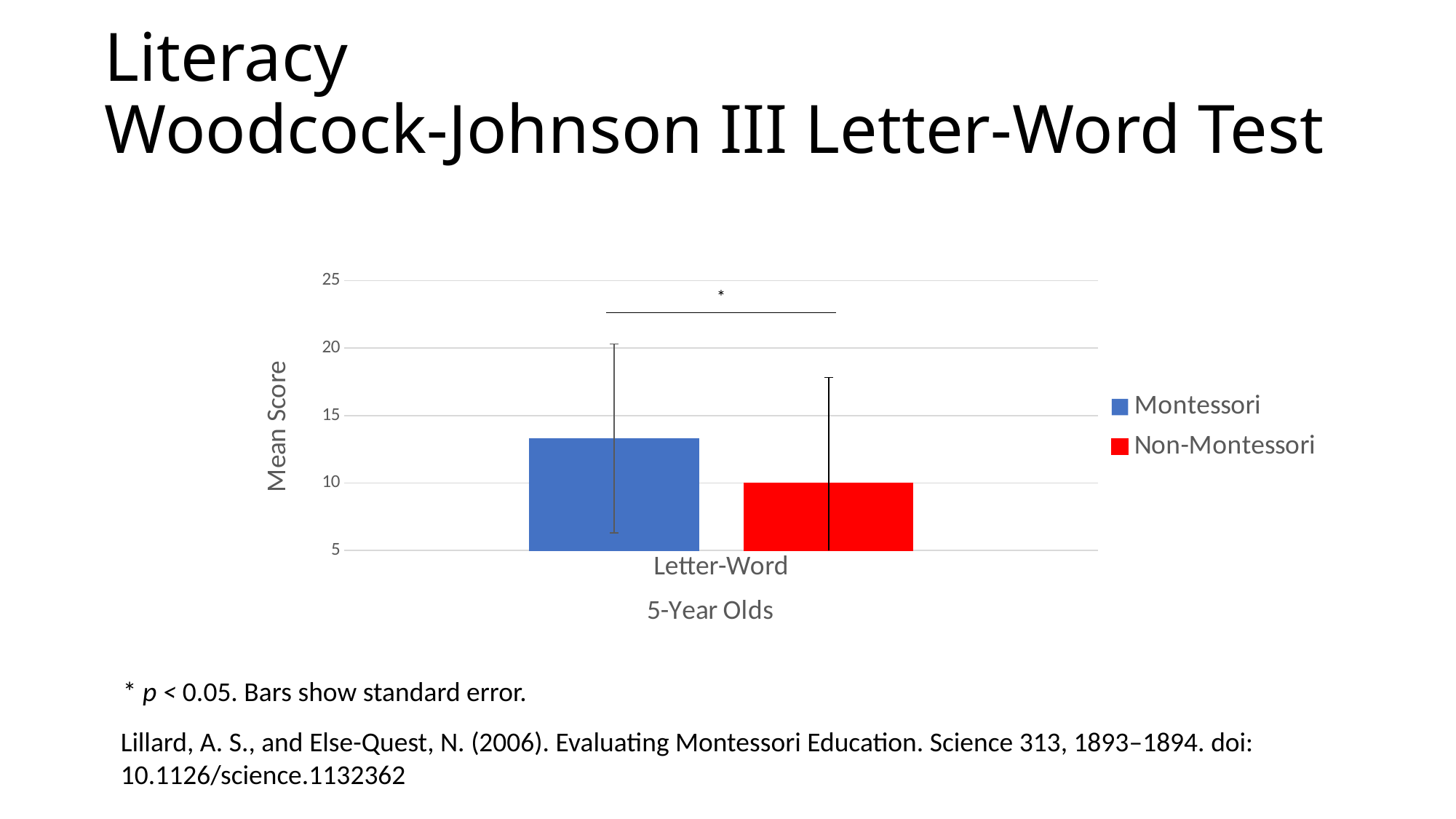
Which series has the lowest mean score on the chart? Non-Montessori What is the label on the y axis of the chart? Mean Score Is the Montessori mean score for Letter-Word greater or less than 10? greater Which colour represents the Non-Montessori series in the legend? red Which series has the higher mean score for Letter-Word? Montessori How many categories are plotted on the x axis? 1 Is the Montessori mean score for Letter-Word greater or less than 15? less What kind of chart is shown on the slide? bar chart Is the Non-Montessori mean score for Letter-Word greater or less than 15? less How many series does the legend list? 2 Which series has the highest mean score on the chart? Montessori